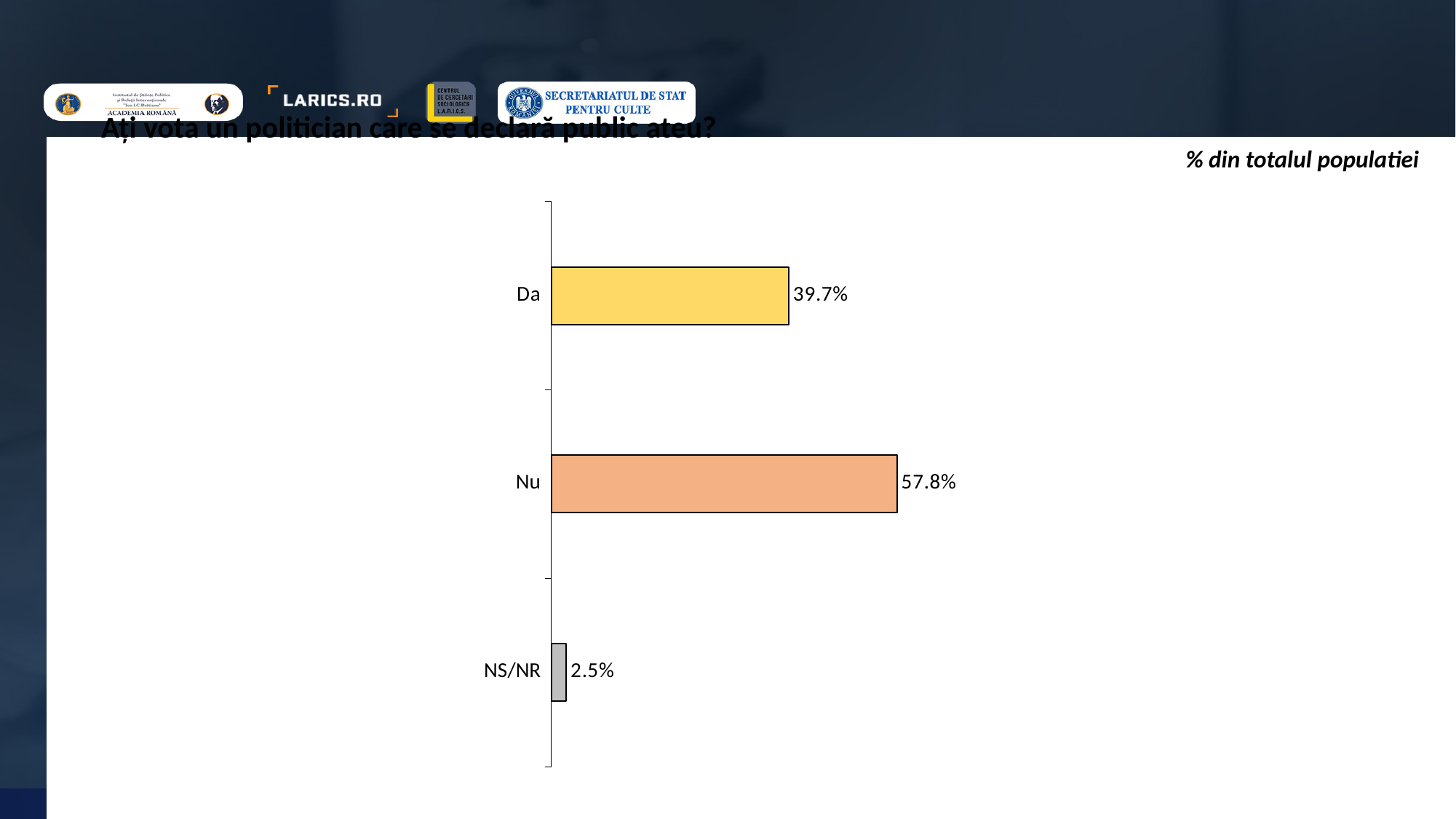
What unit note is shown at the top right of the chart? % din totalul populatiei Which is larger, the value for "Da" or the value for "Nu"? Nu What kind of chart is shown on the slide? bar chart What is the total of the three values shown in the chart? 100% What is the difference between the values for "Nu" and "Da"? 18.1% Which category has the highest value? Nu What is the value for "NS/NR"? 2.5% What is the difference between the values for "Da" and "NS/NR"? 37.2% How many categories are shown in the chart? 3 What is the value for "Da"? 39.7% Which category has the lowest value? NS/NR What is the value for "Nu"? 57.8%